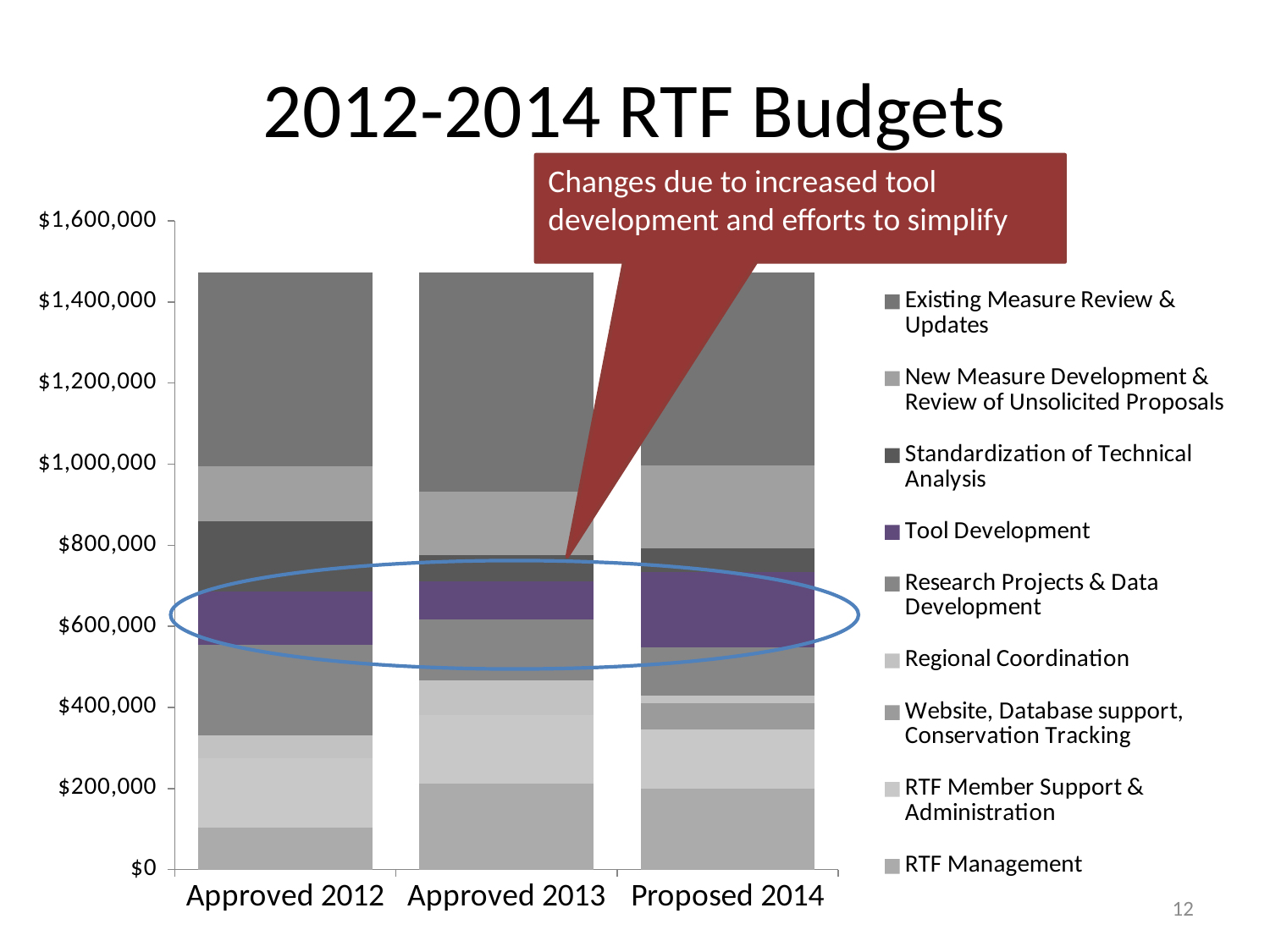
What kind of chart is shown on the slide? Stacked bar chart Which series is shown in purple in the legend? Tool Development How many budget years (bars) are shown on the x axis? 3 Which bar has the largest Tool Development segment? Proposed 2014 Is the total budget for Proposed 2014 greater or less than $1,600,000? less Is the RTF Management segment for Approved 2012 greater or less than $200,000? less What is the title of the chart? 2012-2014 RTF Budgets How many series does the legend list? 9 Which bar has the smallest RTF Management segment? Approved 2012 Is the total budget for Approved 2012 greater or less than $1,400,000? greater Is the Tool Development segment larger for Approved 2013 or Proposed 2014? Proposed 2014 What is the label on the x axis for the third bar? Proposed 2014